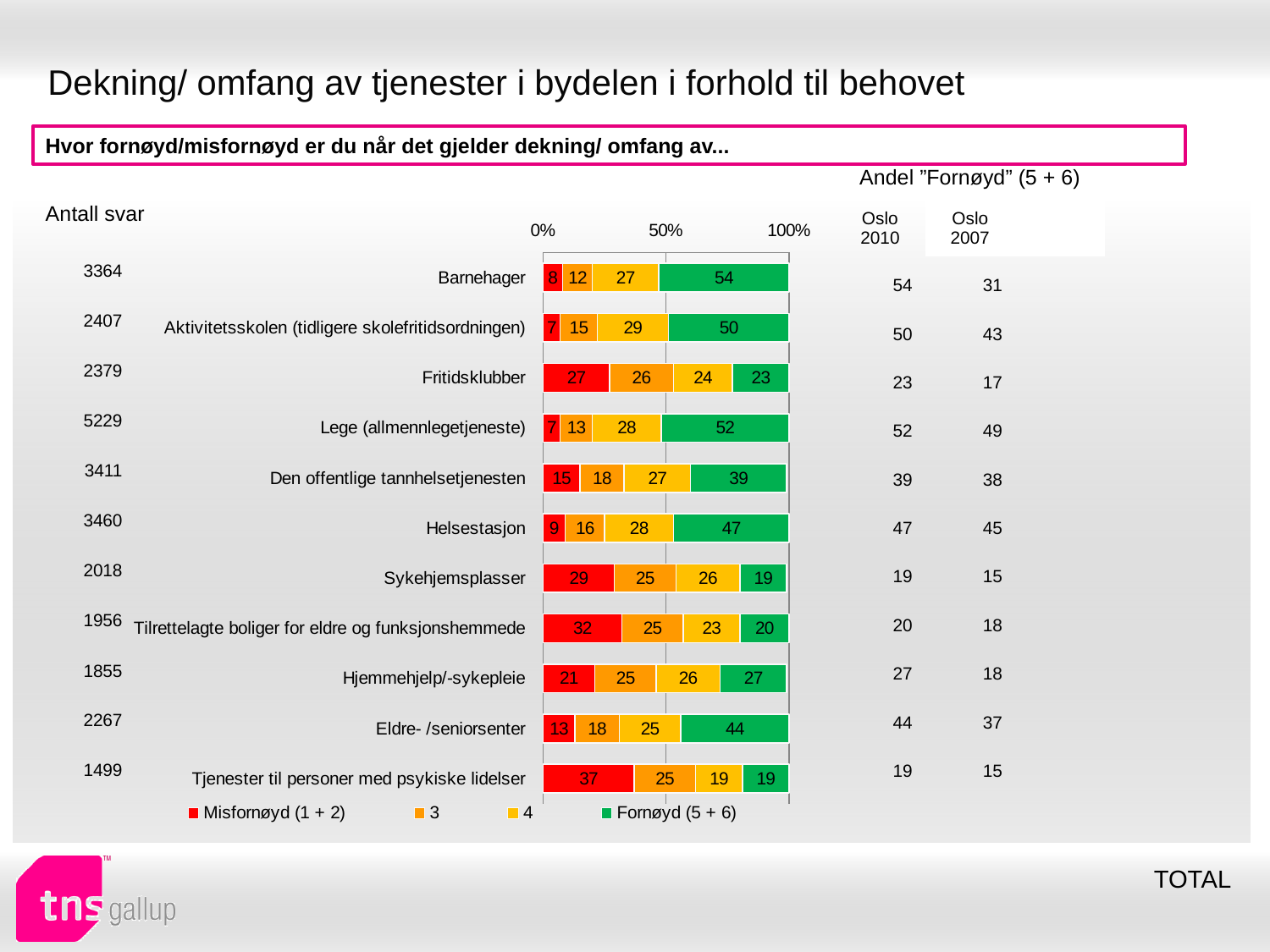
Which has the larger Misfornøyd (1 + 2) value, Fritidsklubber or Sykehjemsplasser? Sykehjemsplasser Which category has the highest Fornøyd (5 + 6) value? Barnehager What is the first entry in the chart legend? Misfornøyd (1 + 2) Which category has the highest Misfornøyd (1 + 2) value? Tjenester til personer med psykiske lidelser How many series does the chart legend list? 4 What kind of chart is shown on the slide? bar chart What is the Misfornøyd (1 + 2) value for Tjenester til personer med psykiske lidelser? 37 What is the difference between the Fornøyd (5 + 6) values for Lege (allmennlegetjeneste) and Helsestasjon? 5 What is the value of series 3 for Hjemmehjelp/-sykepleie? 25 What is the Fornøyd (5 + 6) value for Barnehager? 54 How many service categories are plotted in the chart? 11 What is the total of the stacked bar for Fritidsklubber? 100